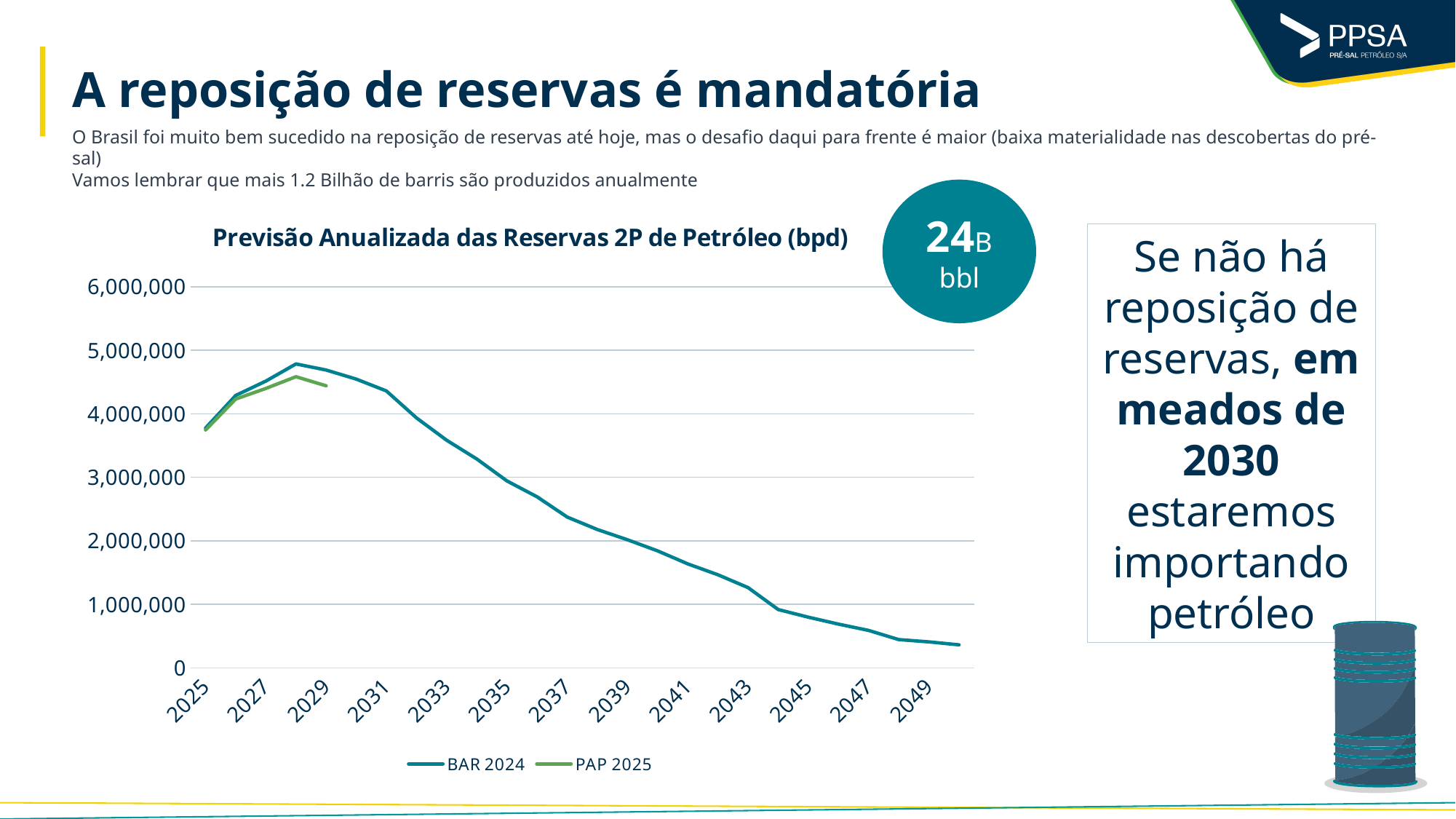
What is the title of the chart? Previsão Anualizada das Reservas 2P de Petróleo (bpd) What kind of chart is shown on the slide? line chart Is the BAR 2024 value for 2025 greater or less than 3,000,000? greater Is the BAR 2024 value for 2031 greater or less than 4,000,000? greater Is the BAR 2024 value for 2037 greater or less than 2,000,000? greater Does the BAR 2024 series rise or fall from 2025 to 2027? rise In 2029, which series has the higher value, BAR 2024 or PAP 2025? BAR 2024 Does the BAR 2024 series rise or fall from 2031 to 2049? fall What are the names of the two series in the legend? BAR 2024 and PAP 2025 What is the highest value shown on the y axis of the chart? 6,000,000 How many series does the chart legend list? 2